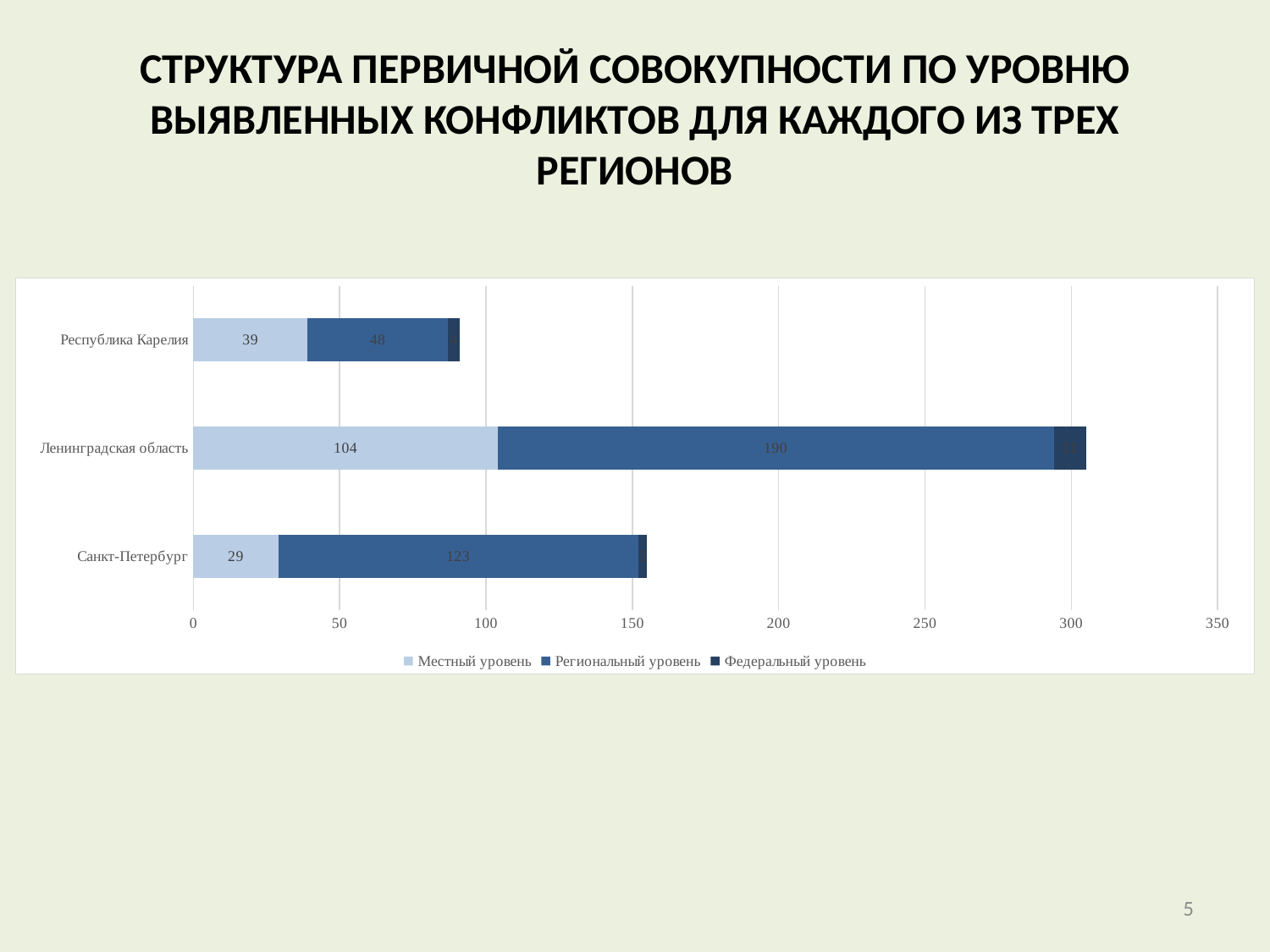
Is the total length of the bar for Ленинградская область greater or less than 300? greater What is the value for Региональный уровень for Санкт-Петербург? 123 What is the value for Региональный уровень for Республика Карелия? 48 Which region has the highest value for Региональный уровень? Ленинградская область What kind of chart is shown on the slide? Stacked bar chart Which region has the lowest value for Местный уровень? Санкт-Петербург What is the value for Местный уровень for Республика Карелия? 39 What is the value for Местный уровень for Ленинградская область? 104 What is the difference between the Региональный уровень values for Ленинградская область and Санкт-Петербург? 67 How many series does the legend list? 3 Which is larger: the Местный уровень value for Республика Карелия or for Санкт-Петербург? Республика Карелия How many regions are shown on the chart? 3